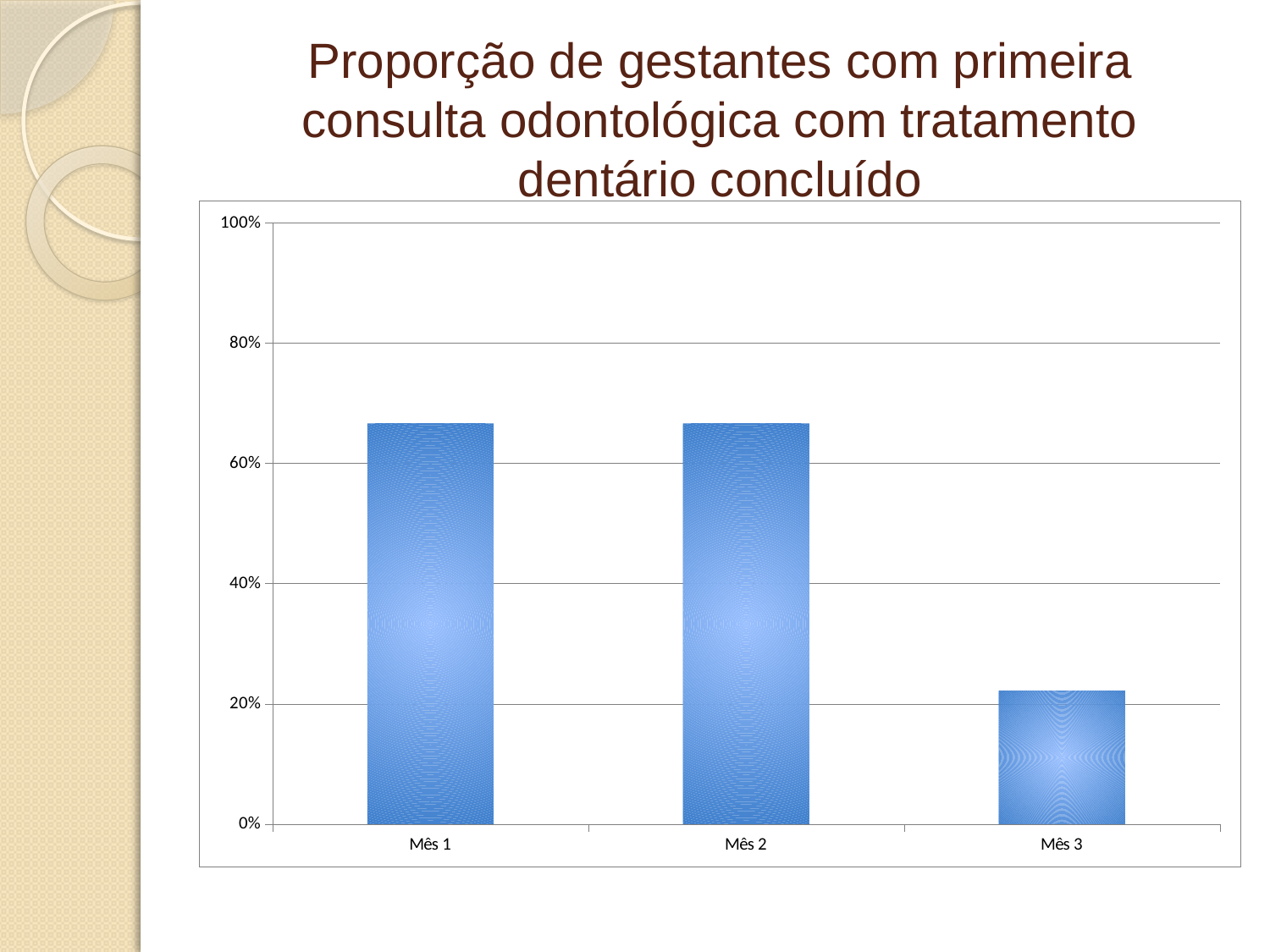
Which is larger, the value for Mês 1 or the value for Mês 3? Mês 1 Is the value for Mês 2 greater or less than 80%? less Which is larger, the value for Mês 2 or the value for Mês 3? Mês 2 What is the title of the chart? Proporção de gestantes com primeira consulta odontológica com tratamento dentário concluído What is the highest value shown on the y axis? 100% Is the value for Mês 3 greater or less than 20%? greater Which category has the lowest value? Mês 3 Is the value for Mês 1 greater or less than 60%? greater What kind of chart is shown on the slide? bar chart How many categories are plotted on the x axis? 3